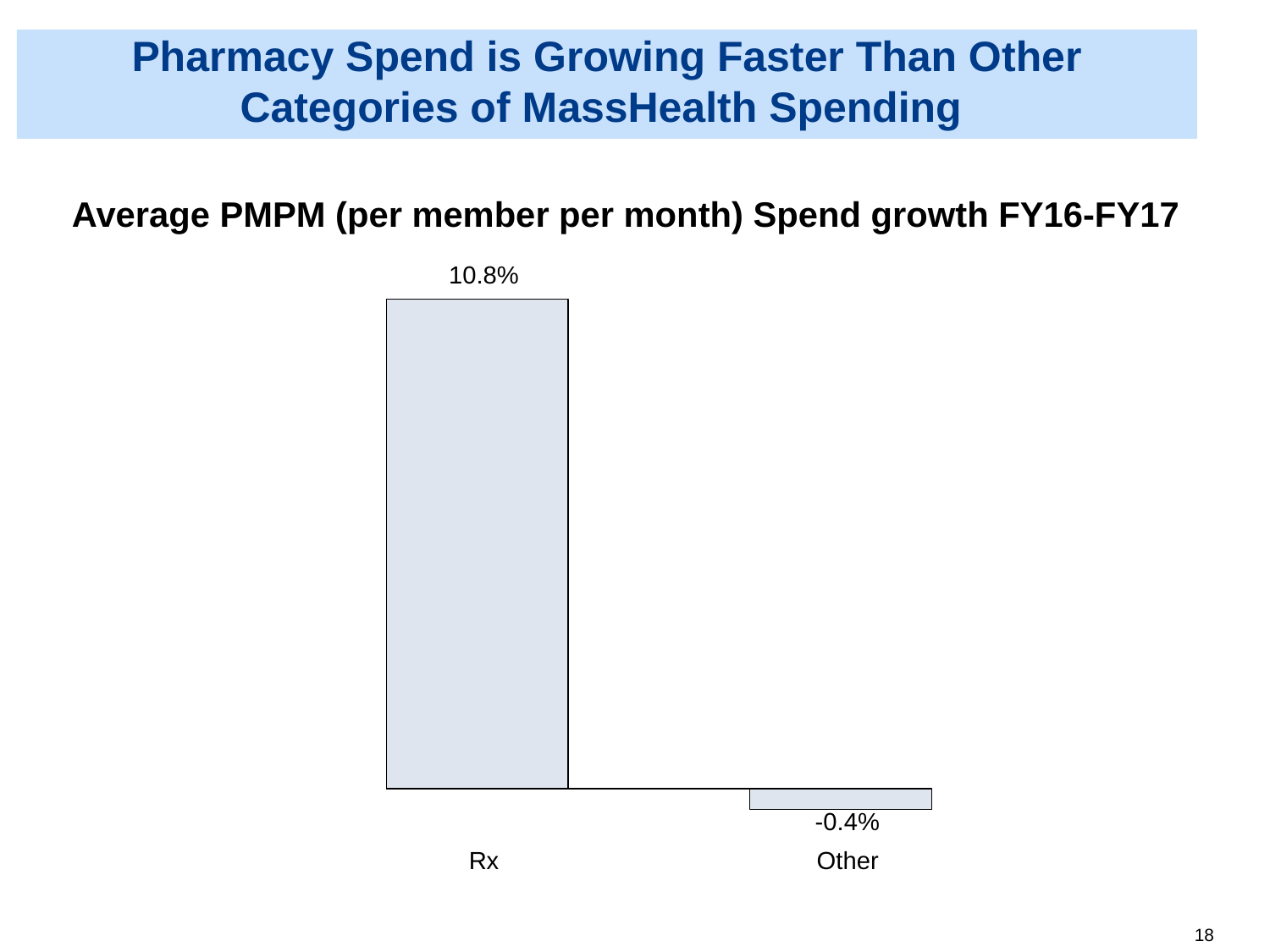
Which category has the highest PMPM spend growth? Rx Is the PMPM spend growth for Other positive or negative? Negative What is the average PMPM spend growth for Other from FY16 to FY17? -0.4% Which category has the lowest PMPM spend growth? Other How many categories are shown in the chart? 2 What is the difference in PMPM spend growth between Rx and Other? 11.2 percentage points What is the title of the chart? Average PMPM (per member per month) Spend growth FY16-FY17 What is the average PMPM spend growth for Rx from FY16 to FY17? 10.8% Which has a larger PMPM spend growth, Rx or Other? Rx What kind of chart is shown on the slide? Bar chart